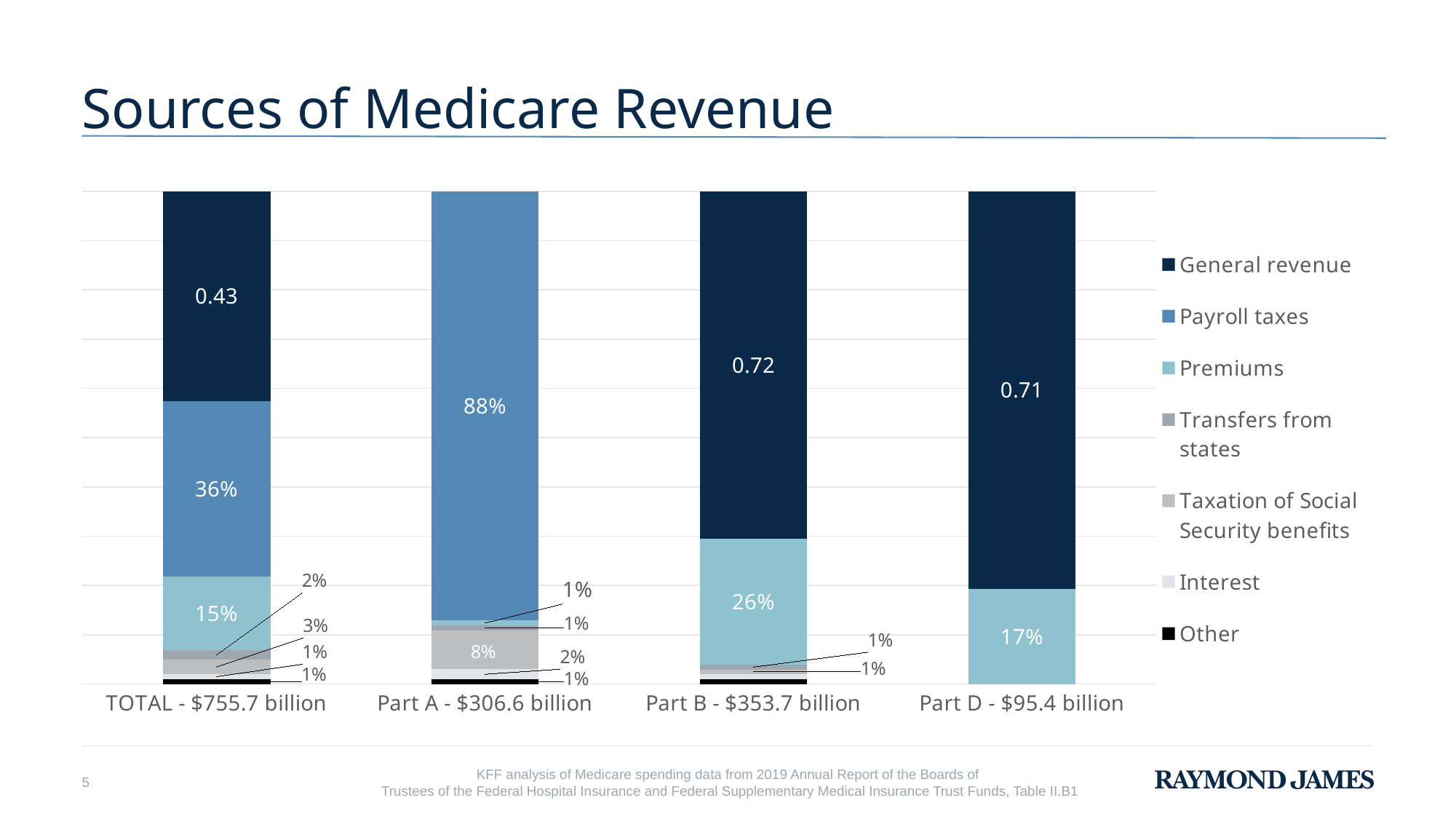
How many series does the legend list? 7 What is the Premiums share for Part D? 17% What is the Payroll taxes share for Part A? 88% Which is larger, the Premiums share for Part B or for Part D? Part B What is the data label for General revenue in the TOTAL bar? 0.43 What is the Payroll taxes share in the TOTAL bar? 36% What is the Premiums share in the TOTAL bar? 15% What kind of chart is shown on the slide? stacked bar chart Which bar has the largest Payroll taxes segment? Part A - $306.6 billion What is the x-axis label of the first bar? TOTAL - $755.7 billion How many bars (categories) are shown on the x axis? 4 What is the data label for General revenue in the Part B bar? 0.72